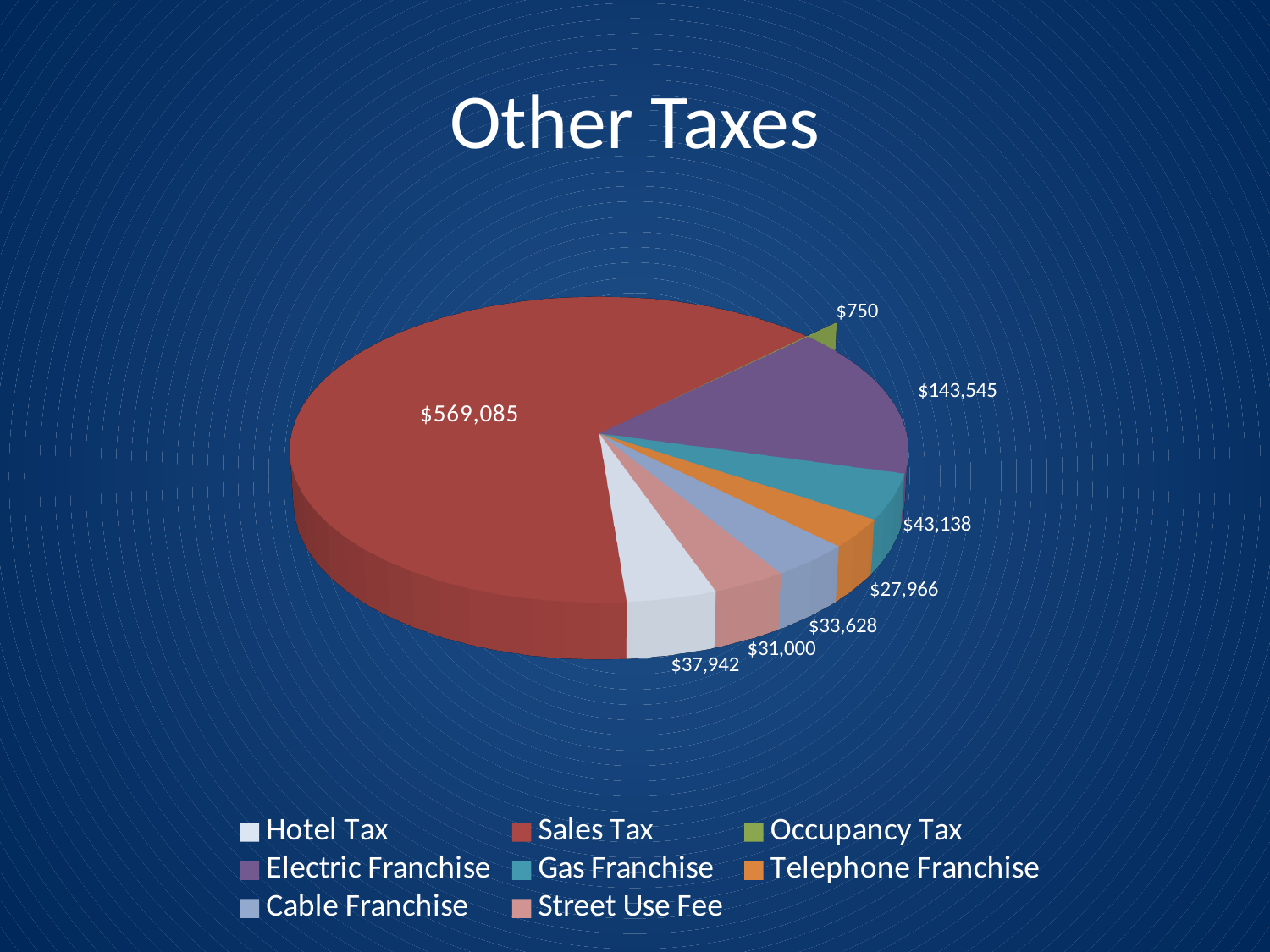
What is the value of the Occupancy Tax slice? $750 What is the difference between the Electric Franchise and Gas Franchise values? $100,407 What is the value of the Sales Tax slice? $569,085 What is the value of the Gas Franchise slice? $43,138 Which is larger, Cable Franchise or Telephone Franchise? Cable Franchise Which category has the largest slice of the pie? Sales Tax What is the value of the Hotel Tax slice? $37,942 What kind of chart is shown on the slide? Pie chart How many categories does the legend list? 8 Which category has the smallest slice of the pie? Occupancy Tax What is the difference between the Hotel Tax and Street Use Fee values? $6,942 What is the value of the Electric Franchise slice? $143,545